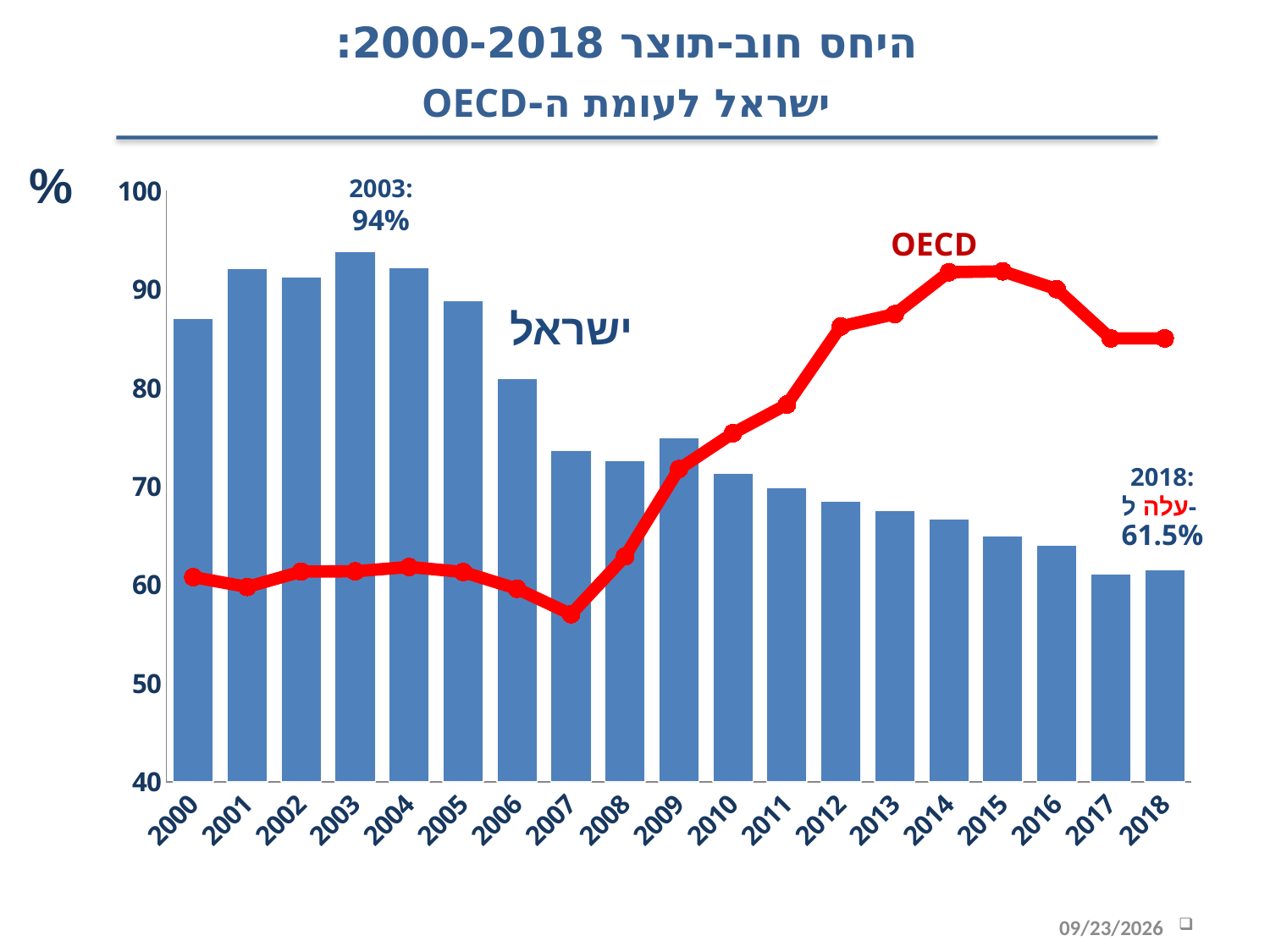
In 2003, which is higher: the Israel bar or the OECD line? Israel What kind of chart is shown on the slide? A bar chart combined with a line chart By how many percentage points did Israel's ratio fall from its 2003 value (94%) to its 2018 value (61.5%)? 32.5 percentage points Is the OECD value for 2007 greater or less than 60? less Do the Israel bars rise or fall from 2009 to 2018? fall What value does the annotation give for Israel's debt-to-GDP ratio in 2018? 61.5% What was Israel's debt-to-GDP ratio in 2003 according to the annotation on the chart? 94% In which year does the OECD line reach its lowest point? 2007 Is the value of the Israel bar for 2000 greater or less than 80? greater In which year is the Israel bar the highest? 2003 How many years are shown on the x axis? 19 In 2018, which is higher: the Israel bar or the OECD line? OECD